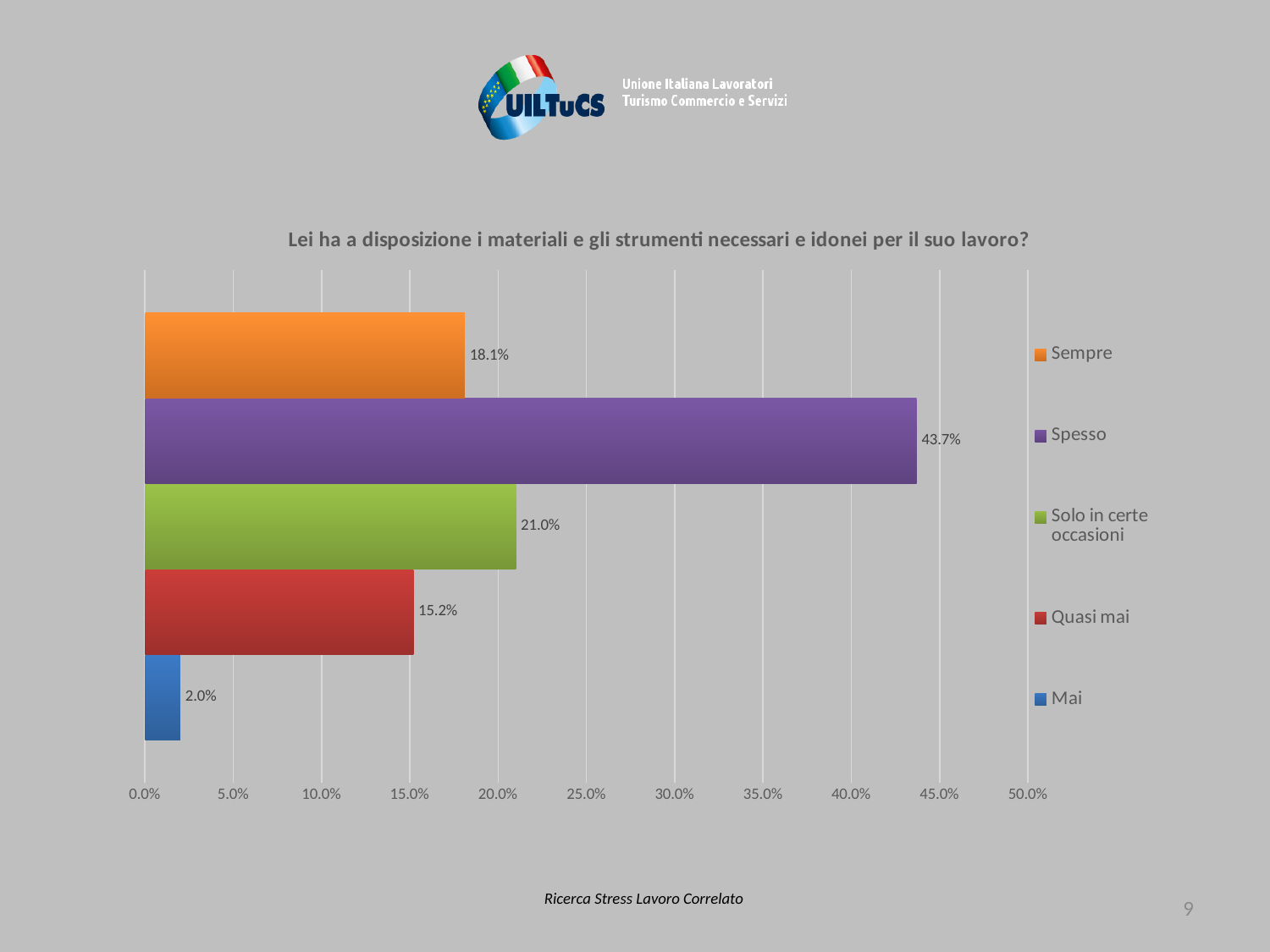
Which category has the highest value? Spesso What is the value for "Solo in certe occasioni"? 21.0% Which category has the lowest value? Mai What is the title of the chart? Lei ha a disposizione i materiali e gli strumenti necessari e idonei per il suo lavoro? What is the value for "Quasi mai"? 15.2% What is the difference between the values for "Spesso" and "Solo in certe occasioni"? 22.7% What is the value for "Sempre"? 18.1% What is the value for "Mai"? 2.0% What kind of chart is shown on the slide? Bar chart What is the value for "Spesso"? 43.7% Which is larger, the value for "Sempre" or the value for "Quasi mai"? Sempre How many categories are shown in the chart? 5